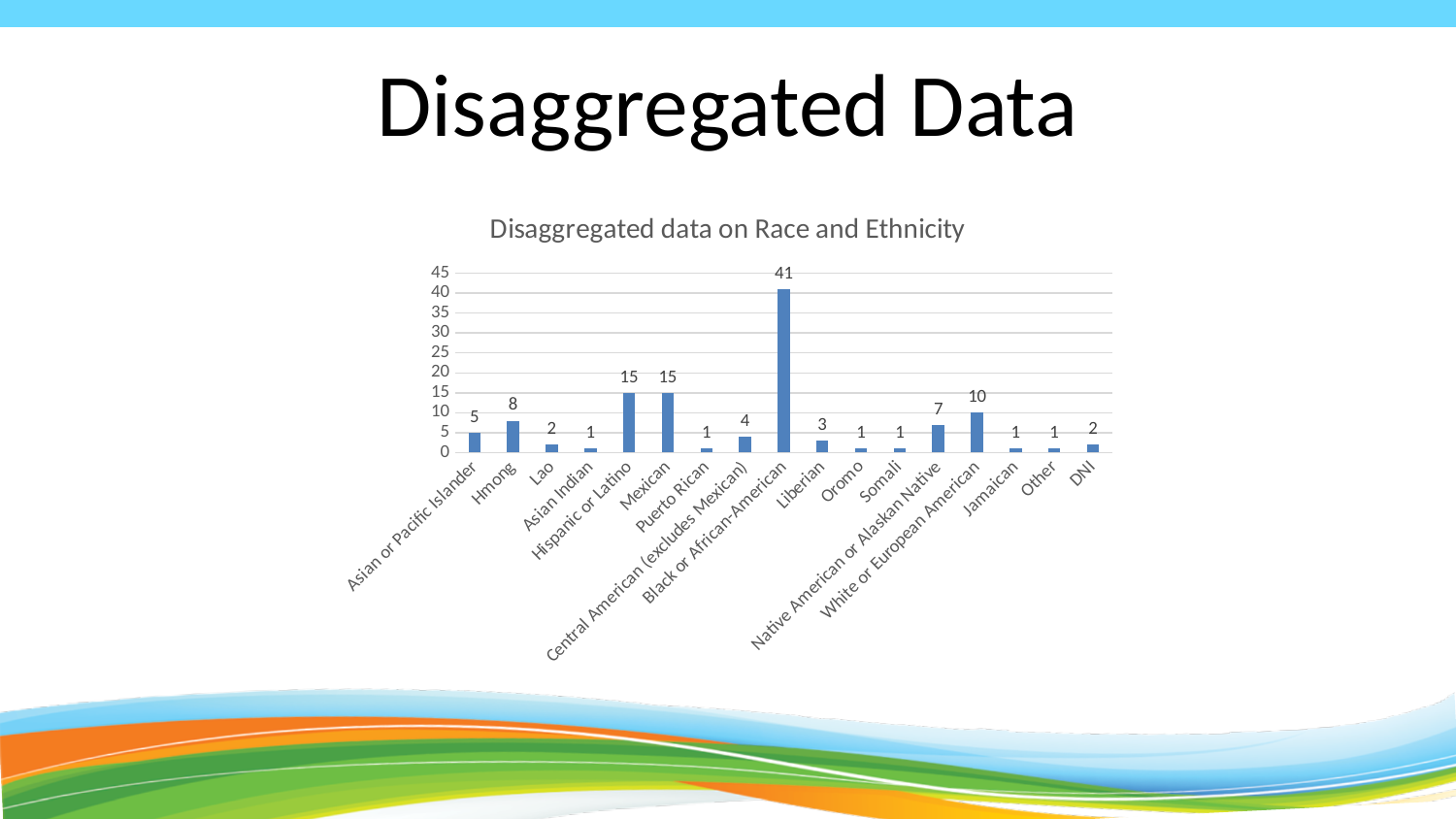
What kind of chart is shown on the slide? Bar chart What is the title of the chart? Disaggregated data on Race and Ethnicity What is the value for Black or African-American? 41 Is the value for Black or African-American greater or less than 40? greater Which category has the highest value? Black or African-American What is the value for Hmong? 8 What is the value for White or European American? 10 What is the difference between the values for White or European American and Native American or Alaskan Native? 3 Which is larger, the value for Hmong or the value for Asian or Pacific Islander? Hmong What is the difference between the values for Black or African-American and Mexican? 26 How many categories are shown on the x axis? 17 What is the value for Central American (excludes Mexican)? 4